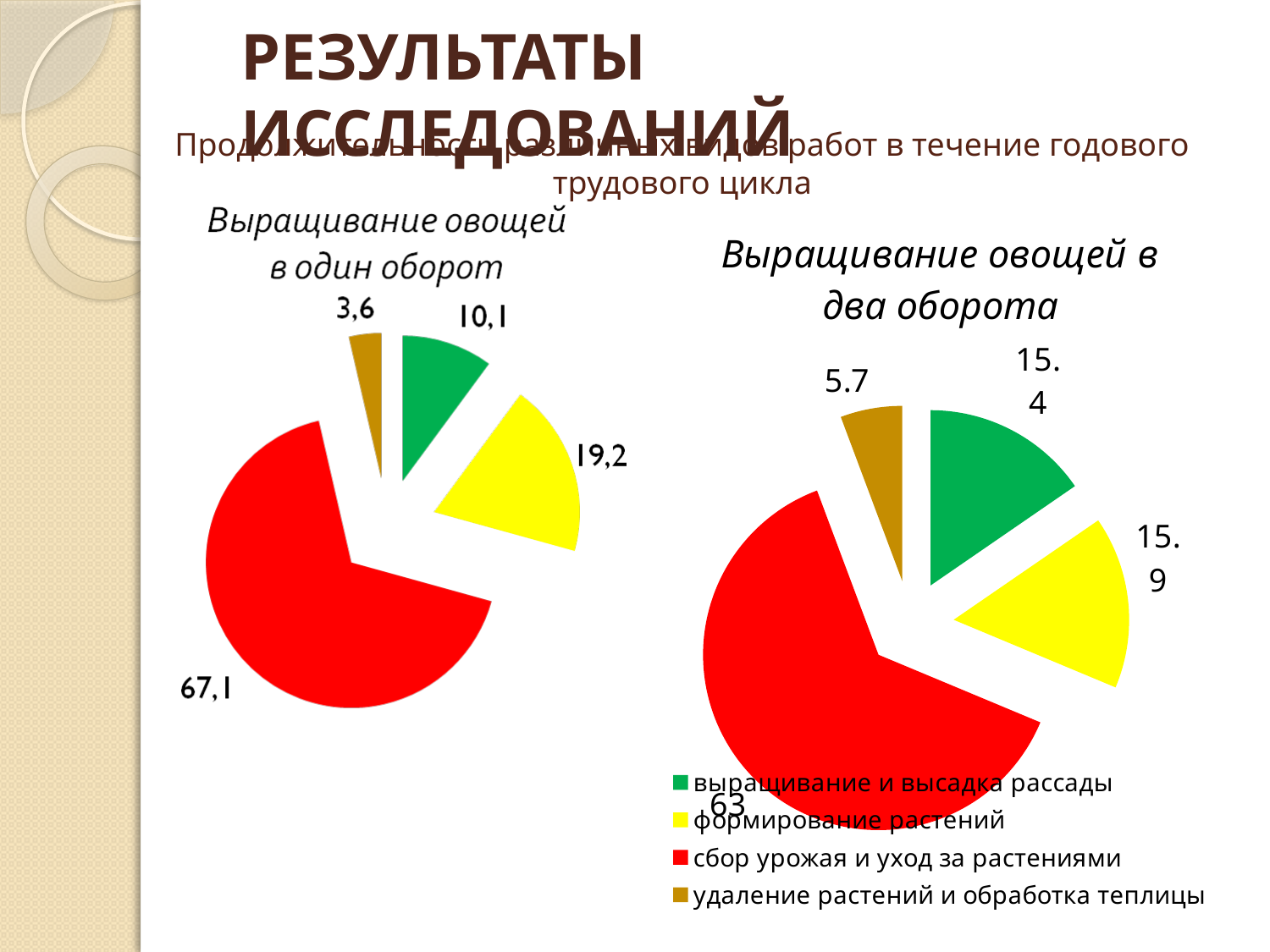
How many slices does each pie chart on the slide have? 4 In the chart 'Выращивание овощей в два оборота', which category has the smallest slice? удаление растений и обработка теплицы In the chart 'Выращивание овощей в два оборота', what is the difference between the values for 'сбор урожая и уход за растениями' and 'удаление растений и обработка теплицы'? 57.3 In the chart 'Выращивание овощей в один оборот', which category has the largest slice? сбор урожая и уход за растениями What kind of charts are shown on the slide? Pie charts In the chart 'Выращивание овощей в два оборота', what is the value for 'формирование растений' (yellow slice)? 15.9 In the chart 'Выращивание овощей в один оборот', what is the difference between the values for 'формирование растений' and 'выращивание и высадка рассады'? 9,1 In the chart 'Выращивание овощей в один оборот', which is larger: the value for 'формирование растений' or for 'выращивание и высадка рассады'? формирование растений In the chart 'Выращивание овощей в один оборот', what is the value for 'сбор урожая и уход за растениями' (red slice)? 67,1 In the chart 'Выращивание овощей в два оборота', what is the value for 'выращивание и высадка рассады' (green slice)? 15.4 Which colour represents 'сбор урожая и уход за растениями' in the legend? Red In the chart 'Выращивание овощей в один оборот', what is the value for 'удаление растений и обработка теплицы' (brown slice)? 3,6